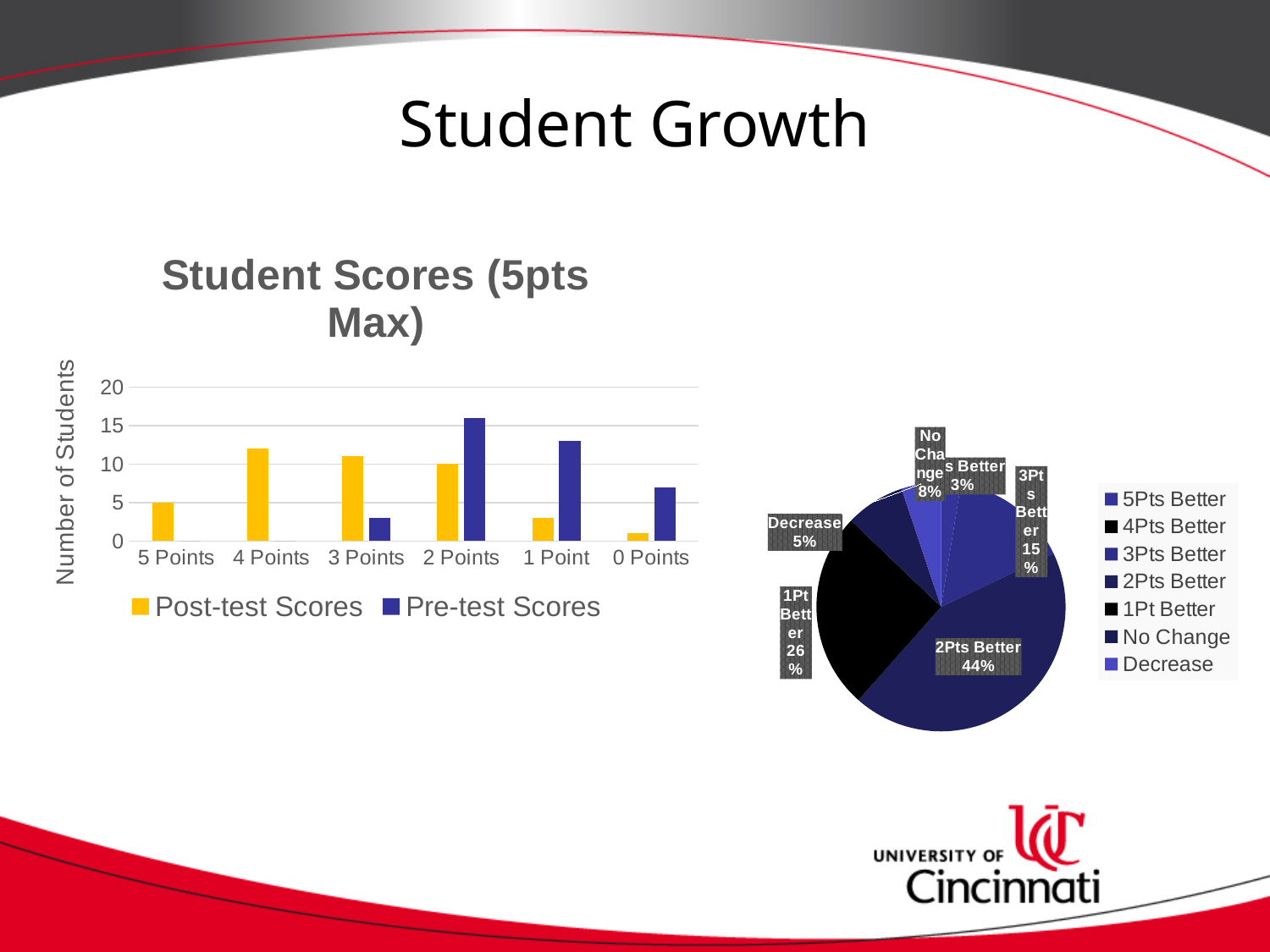
On the Student Scores (5pts Max) chart, is the Post-test Scores value for 1 Point greater or less than 5? less On the Student Scores (5pts Max) chart, for 2 Points, which is larger: Post-test Scores or Pre-test Scores? Pre-test Scores On the pie chart on the right, what share is labelled for 2Pts Better? 44% On the Student Scores (5pts Max) chart, how many score categories are shown on the x axis? 6 On the pie chart on the right, which slice is the largest? 2Pts Better On the Student Scores (5pts Max) chart, what is the label of the y axis? Number of Students On the pie chart on the right, what share is labelled for 1Pt Better? 26% On the Student Scores (5pts Max) chart, what kind of chart is shown? Bar chart On the pie chart on the right, how many entries does the legend list? 7 On the Student Scores (5pts Max) chart, is the Pre-test Scores value for 2 Points greater or less than 15? greater On the Student Scores (5pts Max) chart, how many series does the legend list? 2 On the Student Scores (5pts Max) chart, which category has the highest Pre-test Scores value? 2 Points